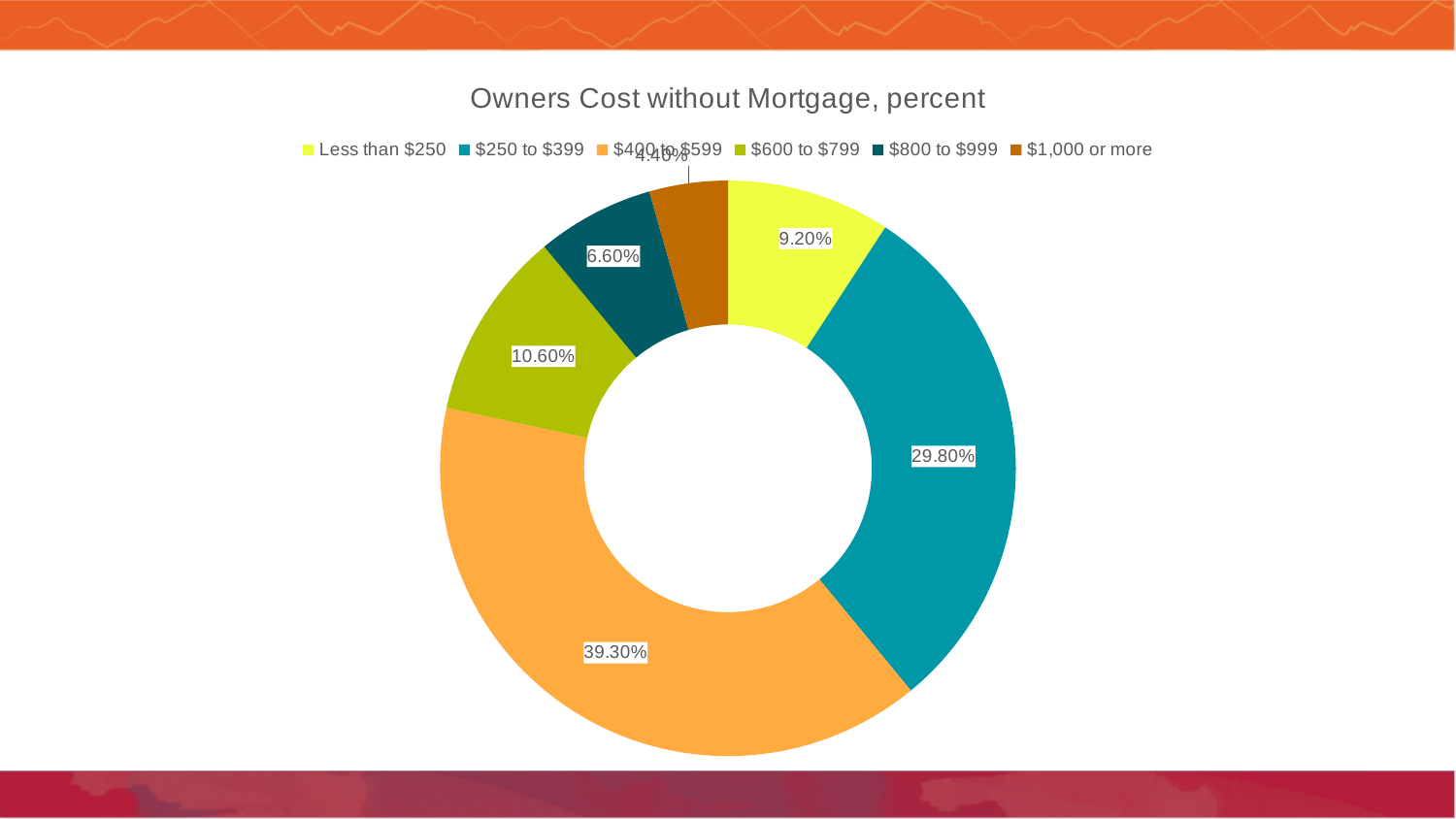
What is the value for the $600 to $799 slice? 10.60% What is the difference between the $400 to $599 share and the $250 to $399 share? 9.50% What is the title of the chart? Owners Cost without Mortgage, percent How many cost categories are shown in the chart? 6 What is the combined share of the $800 to $999 and $1,000 or more categories? 11.00% Which cost category has the largest share of the chart? $400 to $599 What type of chart is shown on the slide? Doughnut chart Which is larger, the share for $600 to $799 or the share for $800 to $999? $600 to $799 What percentage is shown for the Less than $250 category? 9.20% What is the value shown for the $250 to $399 category? 29.80% Which cost category has the smallest share of the chart? $1,000 or more What percentage of owners have a cost without mortgage of $400 to $599? 39.30%